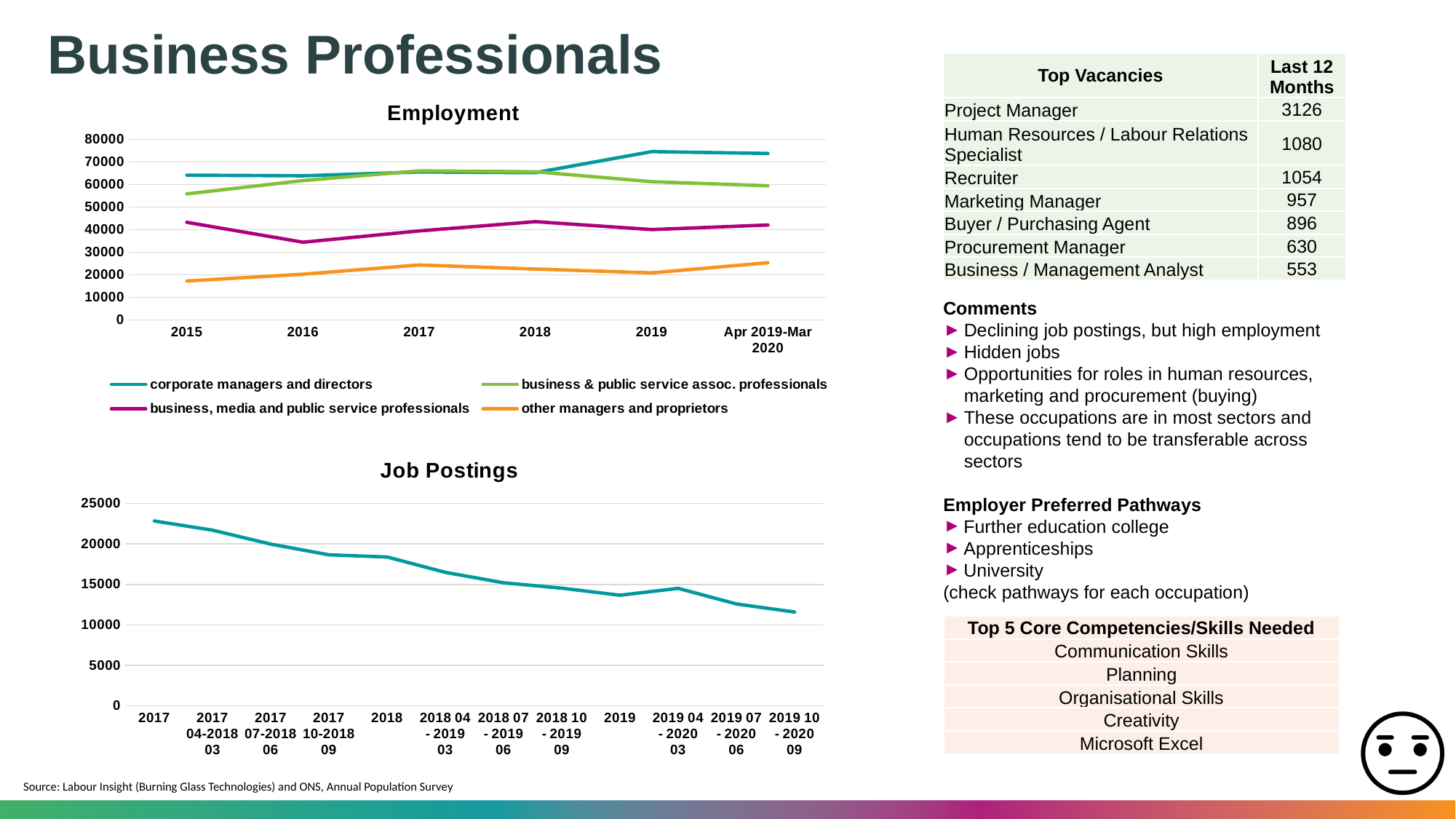
What kind of chart is the Employment chart? line chart In the Job Postings chart, do the values generally rise or fall from 2017 to 2019 10 - 2020 09? fall In the Employment chart, is the value for business, media and public service professionals in 2016 greater or less than 40000? less How many time periods are shown on the x axis of the Employment chart? 6 How many series does the legend of the Employment chart list? 4 In the Employment chart, which series is higher in 2015: corporate managers and directors or business & public service assoc. professionals? corporate managers and directors In the Job Postings chart, which period has the highest value? 2017 What kind of chart is the Job Postings chart? line chart How many time periods are shown on the x axis of the Job Postings chart? 12 In the Employment chart, which series has the lowest values across all periods? other managers and proprietors In the Employment chart, is the value for corporate managers and directors in 2019 greater or less than 70000? greater In the Employment chart, is the value for other managers and proprietors in 2015 greater or less than 20000? less